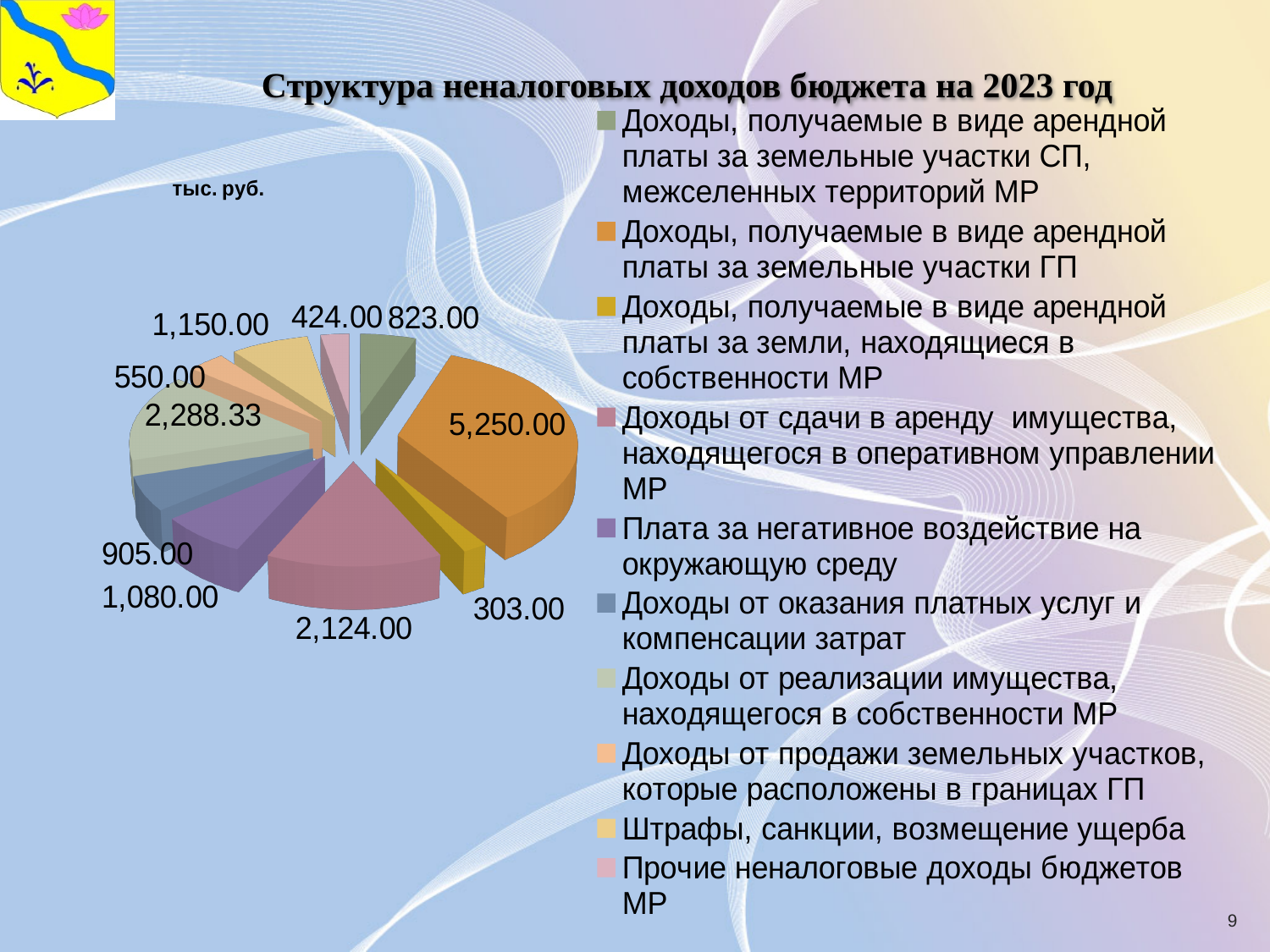
How many slices does the pie chart have? 10 What is the title of the chart? Структура неналоговых доходов бюджета на 2023 год How many entries does the legend list? 10 What is the value for 'Плата за негативное воздействие на окружающую среду'? 1,080.00 What is the difference between 'Доходы от сдачи в аренду имущества, находящегося в оперативном управлении МР' (2,124.00) and 'Доходы от оказания платных услуг и компенсации затрат' (905.00)? 1,219.00 Which category has the smallest value? Доходы, получаемые в виде арендной платы за земли, находящиеся в собственности МР What unit is indicated for the values in the chart? тыс. руб. Which is larger: 'Штрафы, санкции, возмещение ущерба' or 'Прочие неналоговые доходы бюджетов МР'? Штрафы, санкции, возмещение ущерба What is the value for 'Доходы, получаемые в виде арендной платы за земельные участки ГП'? 5,250.00 What is the value for 'Доходы от реализации имущества, находящегося в собственности МР'? 2,288.33 Which category has the largest value? Доходы, получаемые в виде арендной платы за земельные участки ГП What type of chart is shown on the slide? Pie chart